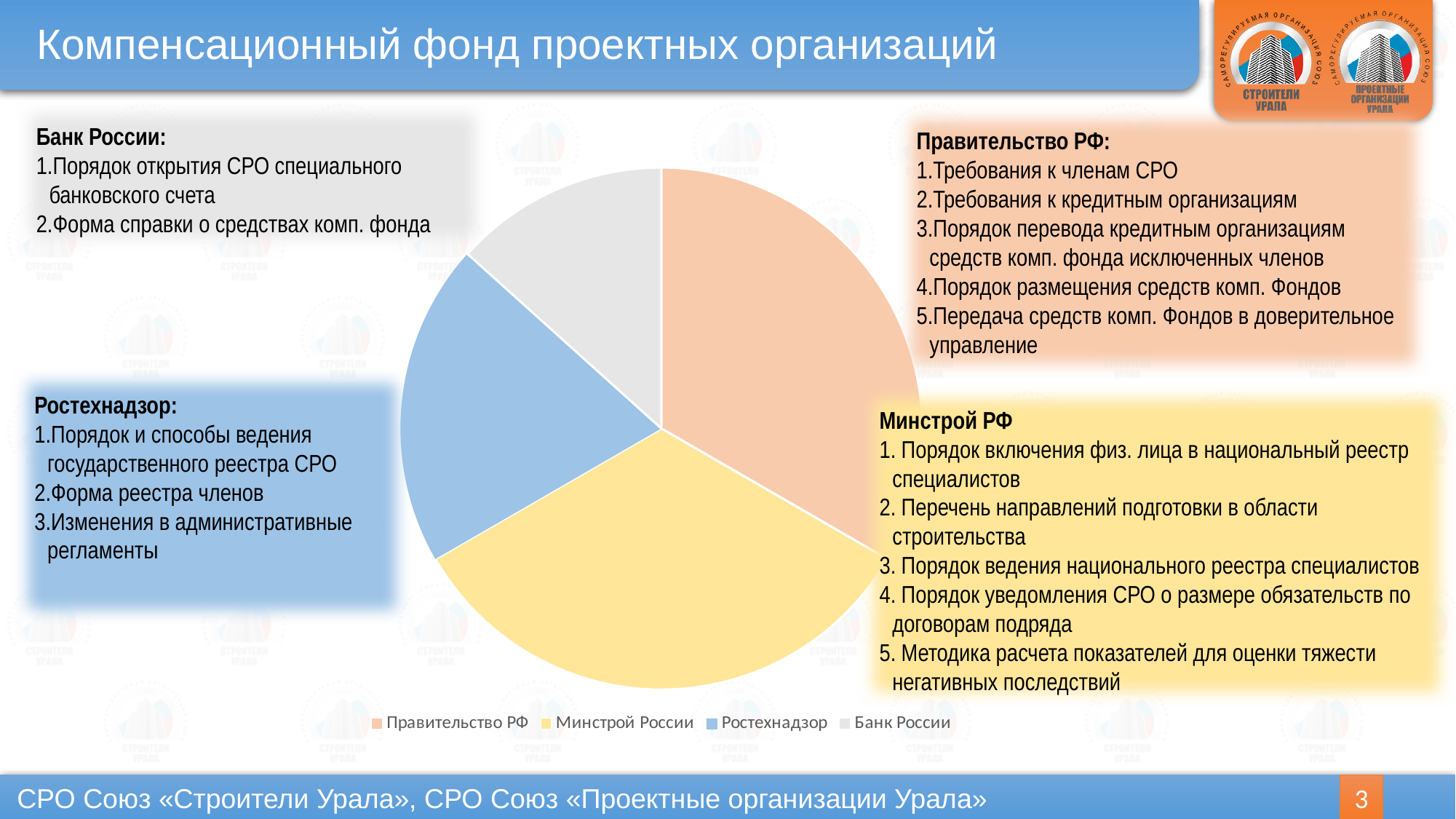
Which legend entry is shown in grey in the pie chart? Банк России Which slice is larger in the pie chart, Минстрой России or Банк России? Минстрой России What kind of chart is shown on the slide? pie chart How many slices does the pie chart have? 4 Which slice is larger in the pie chart, Минстрой России or Ростехнадзор? Минстрой России What colour is the Ростехнадзор slice in the pie chart? blue Which slice is larger in the pie chart, Правительство РФ or Ростехнадзор? Правительство РФ How many entries does the legend of the pie chart list? 4 Which category has the smallest slice in the pie chart? Банк России